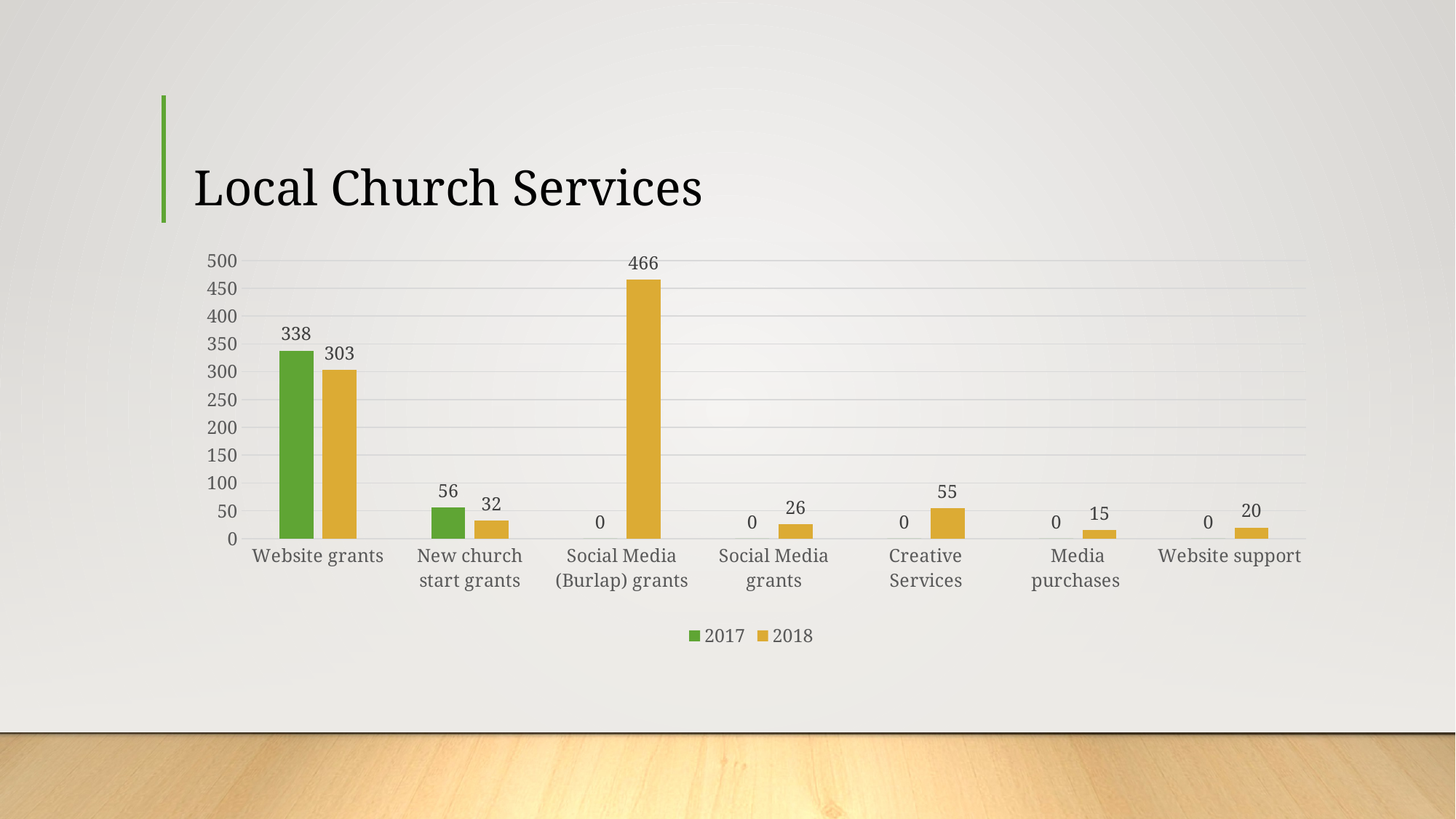
What kind of chart is shown on the slide? Bar chart What is the difference between the 2017 and 2018 values for Website grants? 35 What is the 2018 value for New church start grants? 32 Which is larger for New church start grants, the 2017 value or the 2018 value? 2017 What is the 2018 value for Social Media (Burlap) grants? 466 Which category has the highest 2018 value? Social Media (Burlap) grants How many series does the legend list? 2 How many categories are shown on the x axis? 7 What is the 2017 value for Website grants? 338 Which category has the lowest non-zero 2018 value? Media purchases What is the 2017 value for Creative Services? 0 What is the title of the slide? Local Church Services